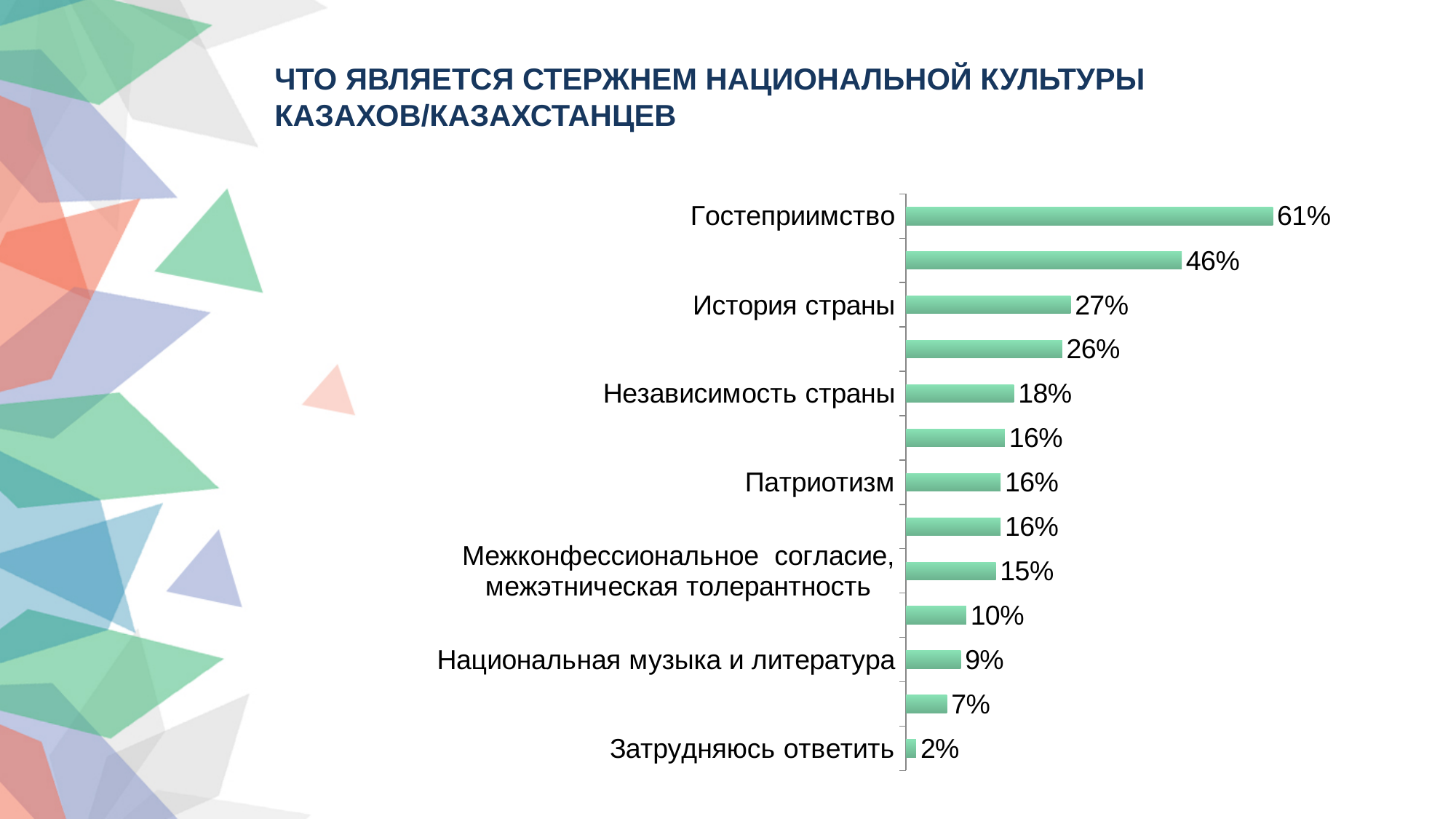
What is the value for Гостеприимство? 61% Which is larger, the value for Независимость страны or the value for Патриотизм? Независимость страны What is the value for История страны? 27% Which labelled category has the lowest value? Затрудняюсь ответить Which labelled category has the highest value? Гостеприимство What is the value for Независимость страны? 18% What is the value for Затрудняюсь ответить? 2% What is the difference between the values for Гостеприимство and История страны? 34% What is the value for Национальная музыка и литература? 9% How many bars are plotted in the chart? 13 What is the value for Патриотизм? 16% What kind of chart is shown on the slide? Bar chart